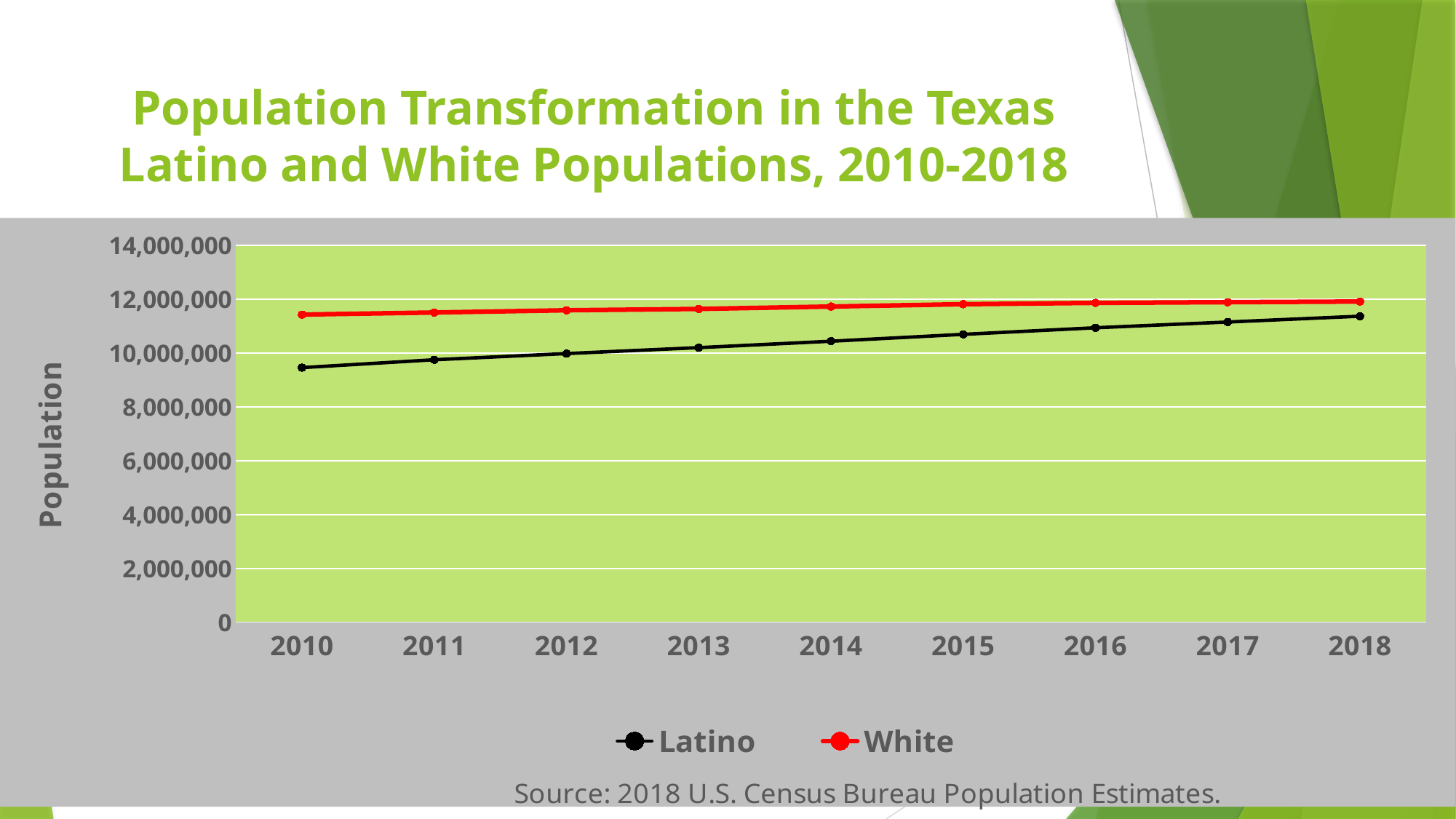
What type of chart is shown on the slide? line chart Does the Latino population rise or fall from 2010 to 2018? rise Is the Latino value for 2010 greater or less than 10,000,000? less In which year is the Latino population lowest? 2010 What colour is the line for the White series? red How many series does the legend list? 2 Is the Latino value for 2018 greater or less than 10,000,000? greater What is the label on the y axis? Population Which series has the higher value in 2010, Latino or White? White Is the White value for 2010 greater or less than 10,000,000? greater How many years are plotted along the x axis? 9